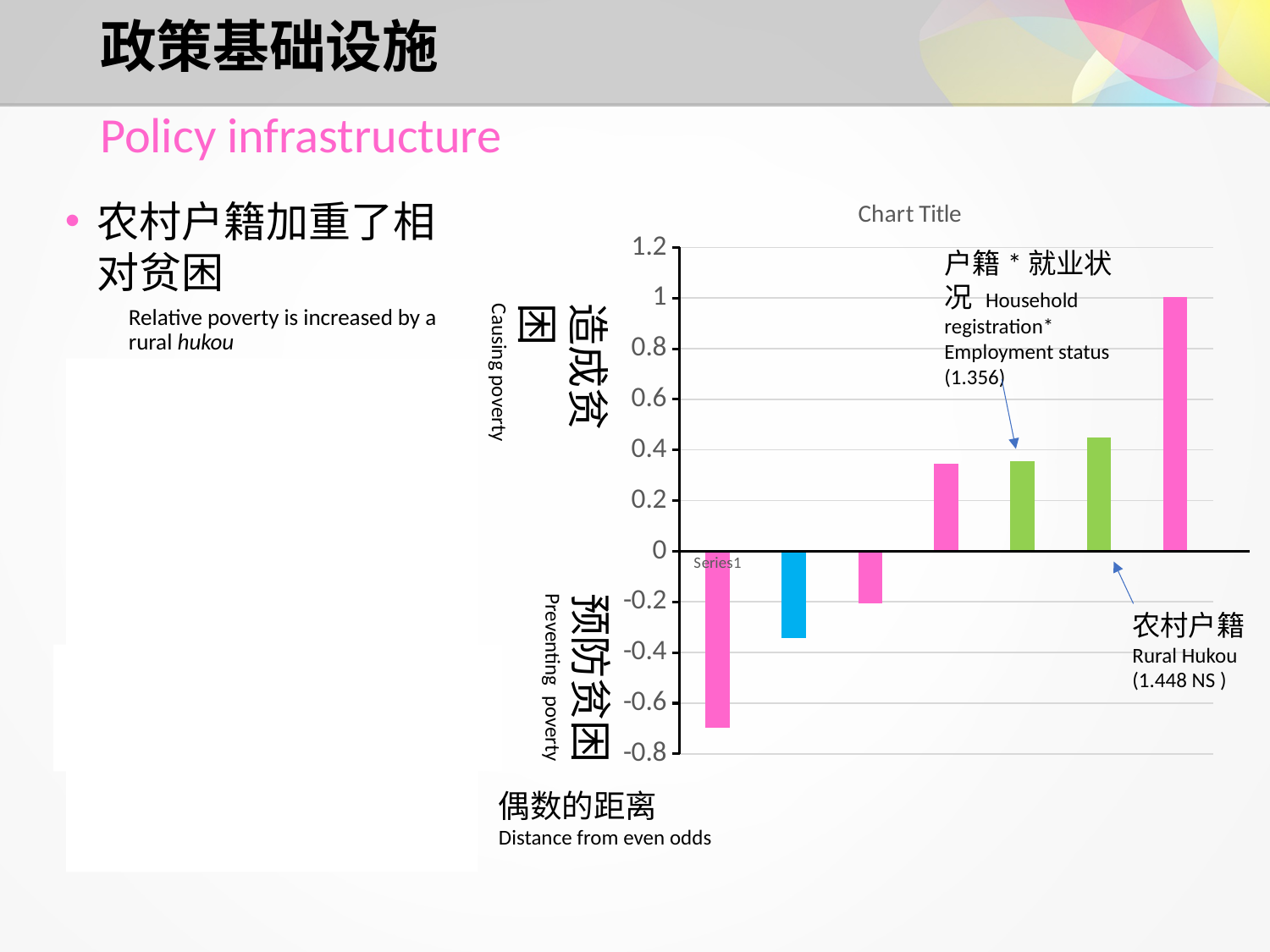
Which bar in the chart has the lowest value? the leftmost bar Is the value of the leftmost bar greater or less than -0.6? less Which bar in the chart has the highest value? the rightmost bar How many bars in the chart extend above zero (into the 'Causing poverty' region)? 4 Is the value of the rightmost bar greater or less than 0.8? greater Which is larger, the value of the rightmost bar or the value of the bar labelled 'Household registration* Employment status'? the rightmost bar How many bars in the chart extend below zero (into the 'Preventing poverty' region)? 3 How many bars are plotted in the chart? 7 What value is given in the annotation for 'Rural Hukou' on the chart? 1.448 NS Is the value of the blue bar greater or less than -0.2? less What kind of chart is shown on the slide? bar chart What is the title shown above the chart? Chart Title